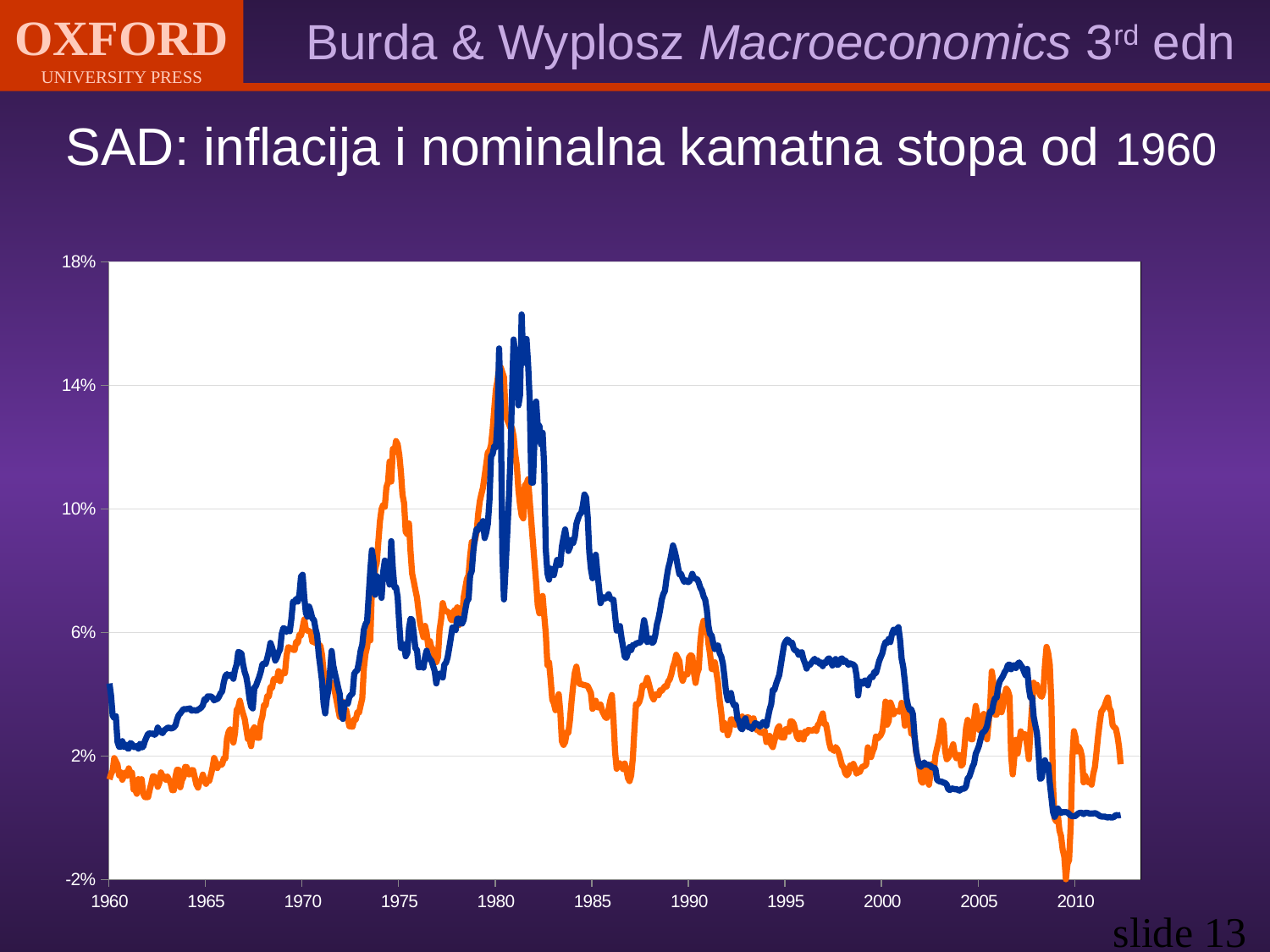
Is the peak of the orange line around 1975 greater or less than 10%? greater How many year labels are shown on the x axis? 11 Is the peak of the blue line around 1981 greater or less than 14%? greater What is the highest value labelled on the y axis? 18% What is the title of the slide above the chart? SAD: inflacija i nominalna kamatna stopa od 1960 Does the blue line rise or fall between 1960 and 1970? rise What kind of chart is shown on the slide? line chart How many lines are plotted on the chart? 2 Does the blue line rise or fall between 1981 and 1986? fall Is the value of the orange line around 1965 greater or less than 2%? less Around 1981, which line reaches a higher peak, the blue line or the orange line? the blue line